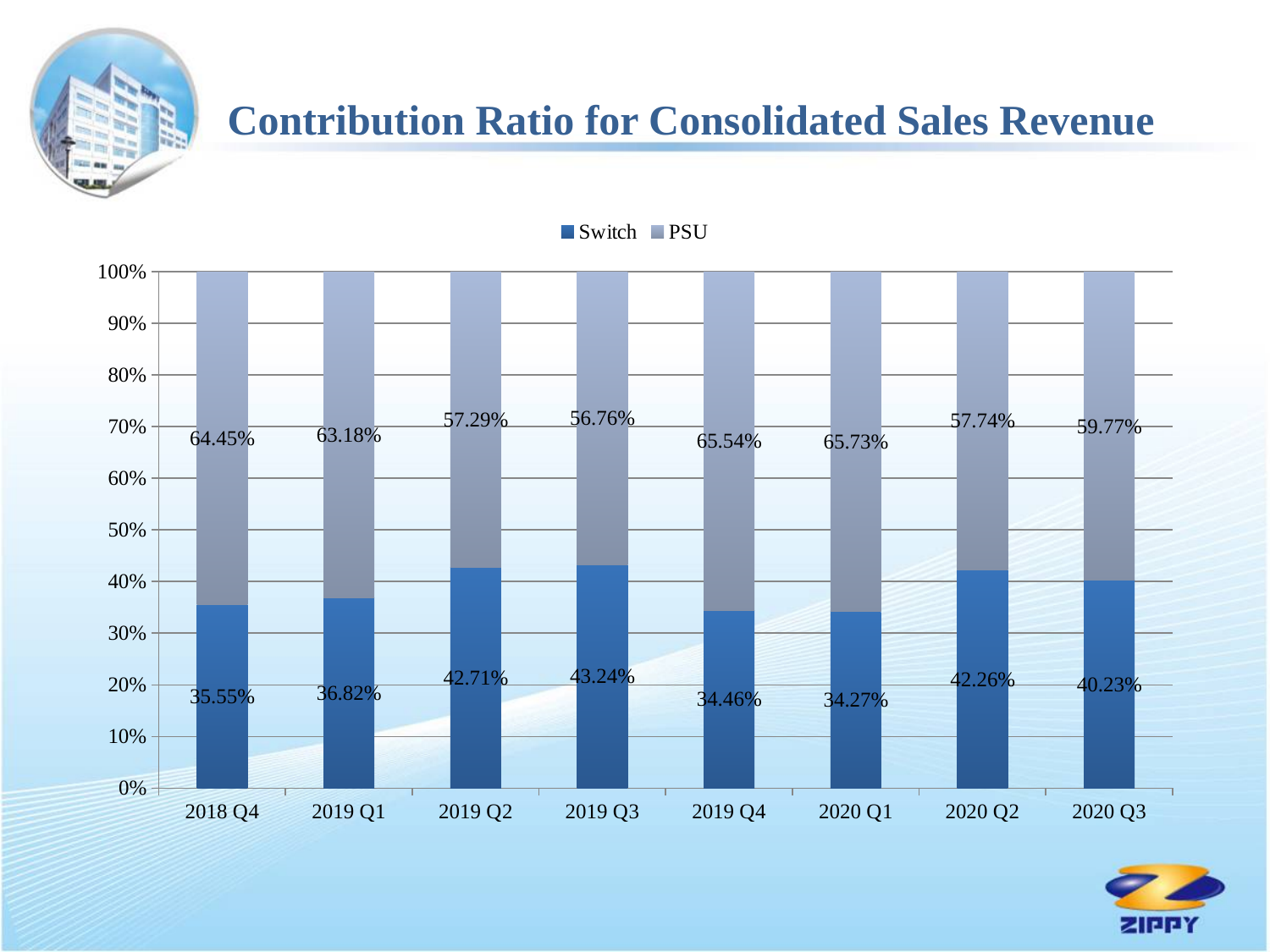
What is the total of the stacked bar for 2019 Q1? 100% What is the title of the chart? Contribution Ratio for Consolidated Sales Revenue Which is larger in 2020 Q2, the Switch ratio or the PSU ratio? PSU What kind of chart is shown on the slide? Stacked bar chart What is the Switch contribution ratio for 2020 Q3? 40.23% In which quarter is the Switch contribution ratio highest? 2019 Q3 In which quarter is the PSU contribution ratio lowest? 2019 Q3 What is the PSU contribution ratio for 2020 Q1? 65.73% What is the difference between the PSU and Switch contribution ratios in 2018 Q4? 28.90% What is the Switch contribution ratio for 2019 Q3? 43.24% How many series does the legend list? 2 How many quarters are shown on the x axis? 8